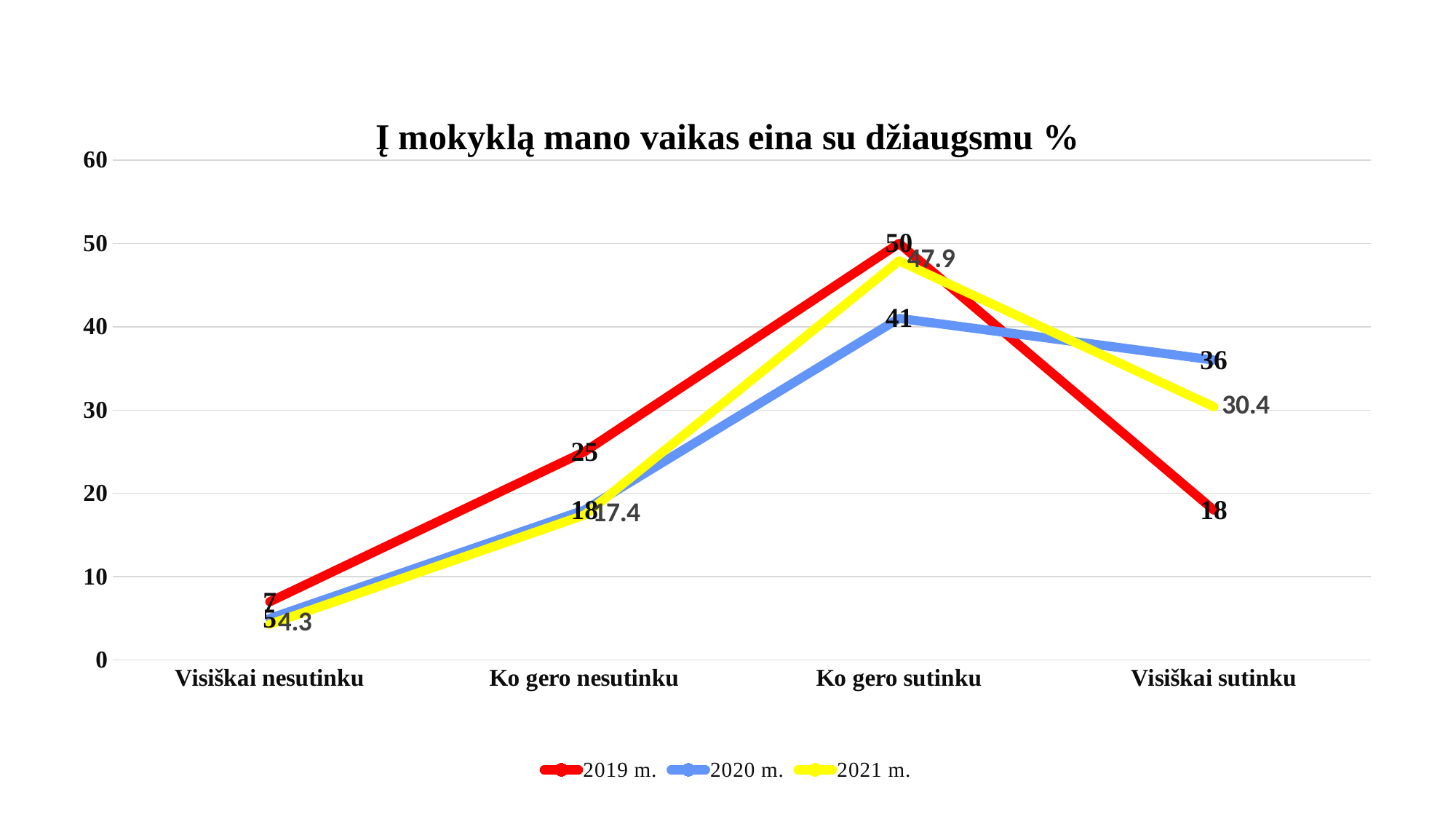
Which category has the highest value for 2020 m.? Ko gero sutinku What is the title of the chart? Į mokyklą mano vaikas eina su džiaugsmu % How many series does the legend list? 3 How many categories are shown on the x axis? 4 What kind of chart is shown on the slide? Line chart What is the value for 2019 m. at Ko gero sutinku? 50 Which category has the lowest value for 2021 m.? Visiškai nesutinku What is the difference between the 2020 m. and 2019 m. values at Visiškai sutinku? 18 What is the value for 2021 m. at Visiškai sutinku? 30.4 At Ko gero sutinku, which series has the larger value, 2019 m. or 2020 m.? 2019 m. What is the value for 2020 m. at Ko gero nesutinku? 18 What is the value for 2019 m. at Visiškai nesutinku? 7